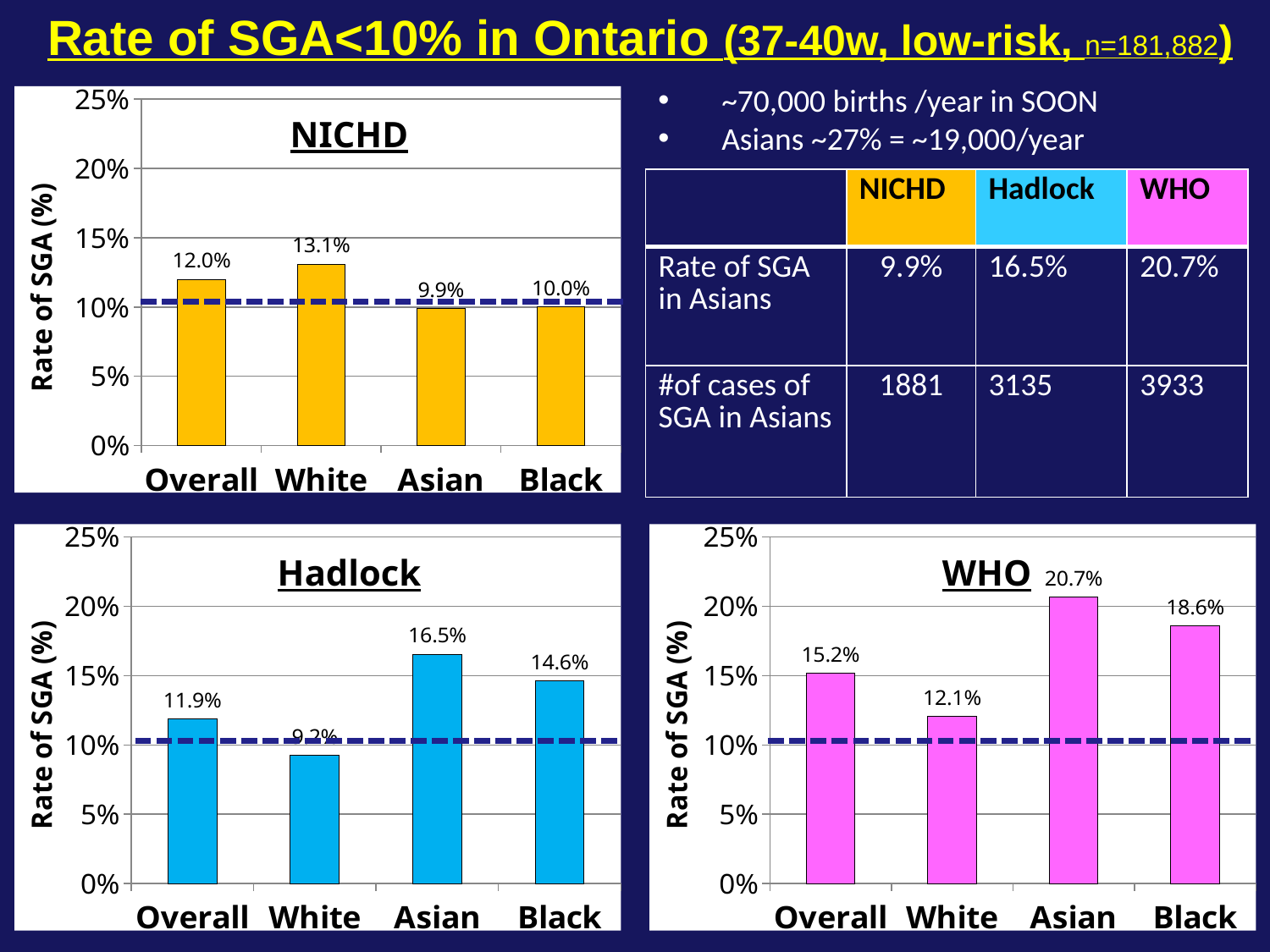
How many categories are shown on the x axis of the Hadlock chart? 4 In the WHO chart, which category has the lowest rate of SGA? White In the NICHD chart, what is the rate of SGA for White? 13.1% In the NICHD chart, what is the difference between the Overall and Black rates of SGA? 2.0% In the Hadlock chart, which category has the highest rate of SGA? Asian In the WHO chart, is the value for Asian greater or less than 20%? greater In the WHO chart, which is larger, the rate for Asian or the rate for Black? Asian What type of chart is the NICHD chart? bar chart In the WHO chart, what is the rate of SGA for Overall? 15.2% In the Hadlock chart, what is the difference between the Asian and White rates of SGA? 7.3% In the NICHD chart, which category has the lowest rate of SGA? Asian In the Hadlock chart, what is the rate of SGA for Asian? 16.5%